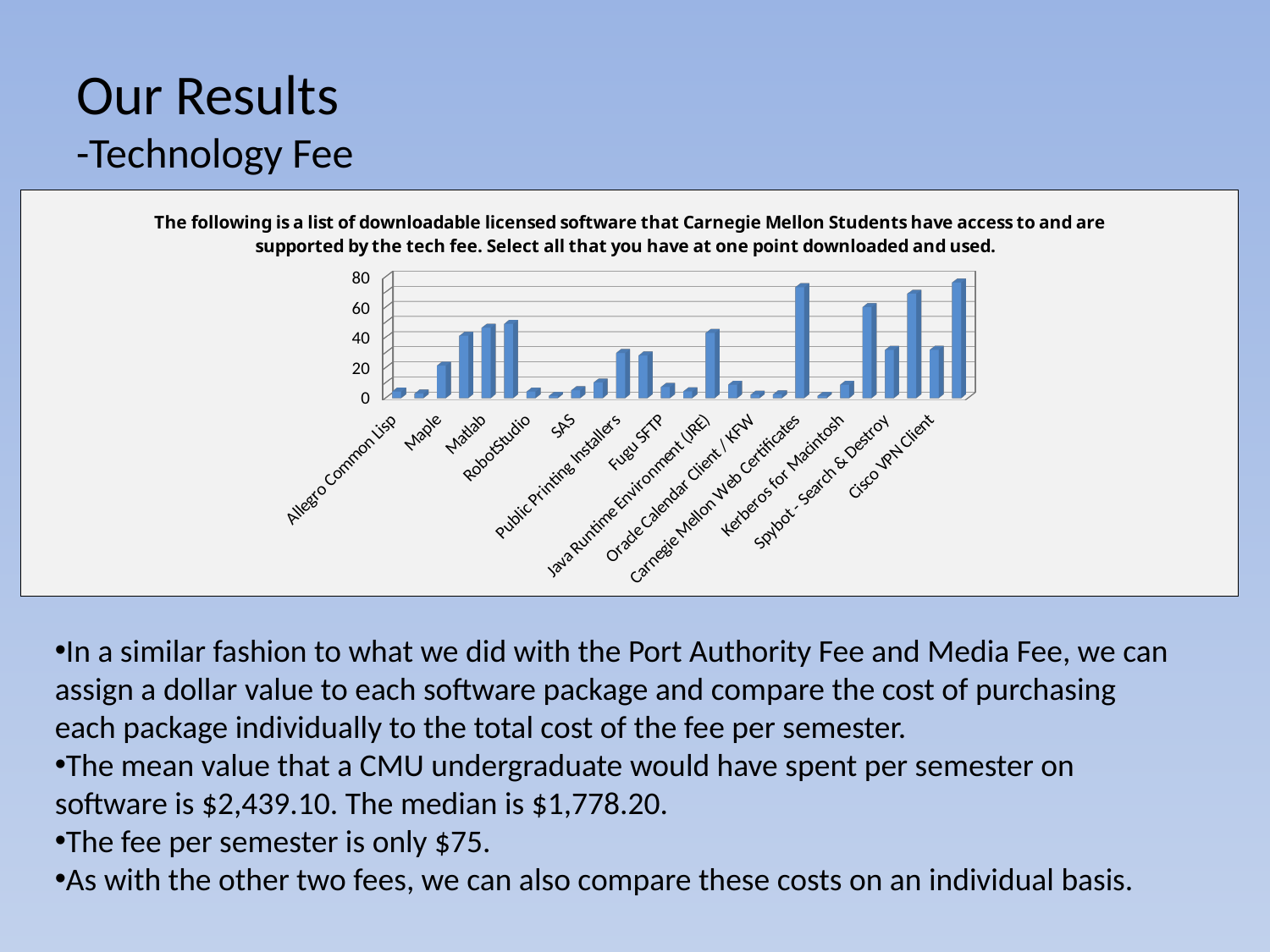
What is the highest value shown on the vertical axis of the chart? 80 Which has a larger value, Matlab or RobotStudio? Matlab Is the value for Spybot - Search & Destroy greater or less than 40? less Which software package is the first category on the horizontal axis of the chart? Allegro Common Lisp Which has a larger value, Carnegie Mellon Web Certificates or Allegro Common Lisp? Carnegie Mellon Web Certificates What kind of chart is shown on the slide? bar chart Is the value for Allegro Common Lisp greater or less than 20? less Is the value for Carnegie Mellon Web Certificates greater or less than 60? greater